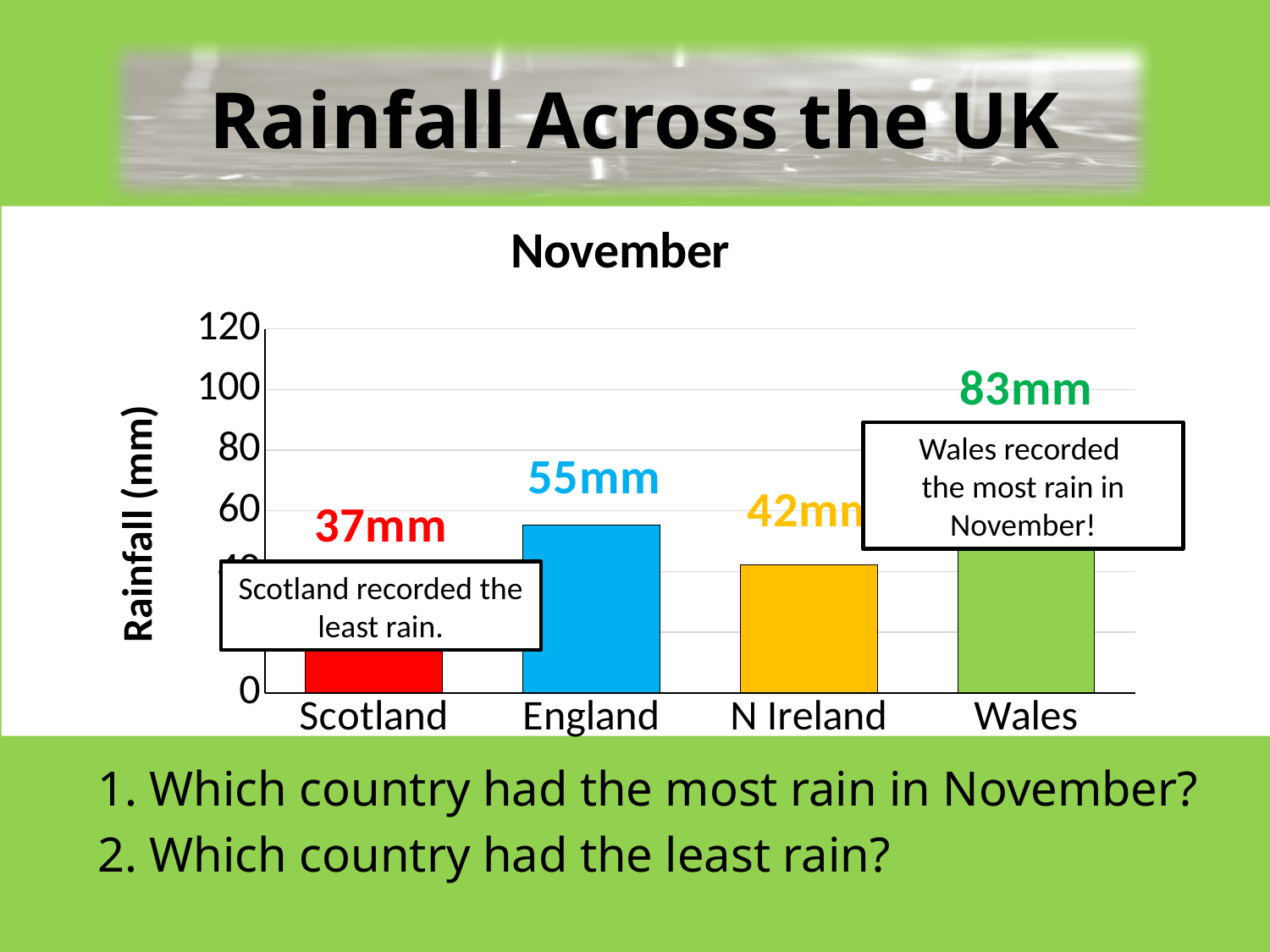
What was the rainfall for N Ireland in November? 42mm How much more rain did Wales record than Scotland in November? 46mm What is the label on the vertical axis of the chart? Rainfall (mm) What was the rainfall for Scotland in November? 37mm What was the rainfall for England in November? 55mm What is the difference in rainfall between England and N Ireland? 13mm What was the rainfall for Wales in November? 83mm What type of chart is shown on the slide? Bar chart Which had more rain in November, England or N Ireland? England How many countries are shown on the chart? 4 Which country had the most rain in November? Wales Which country had the least rain in November? Scotland